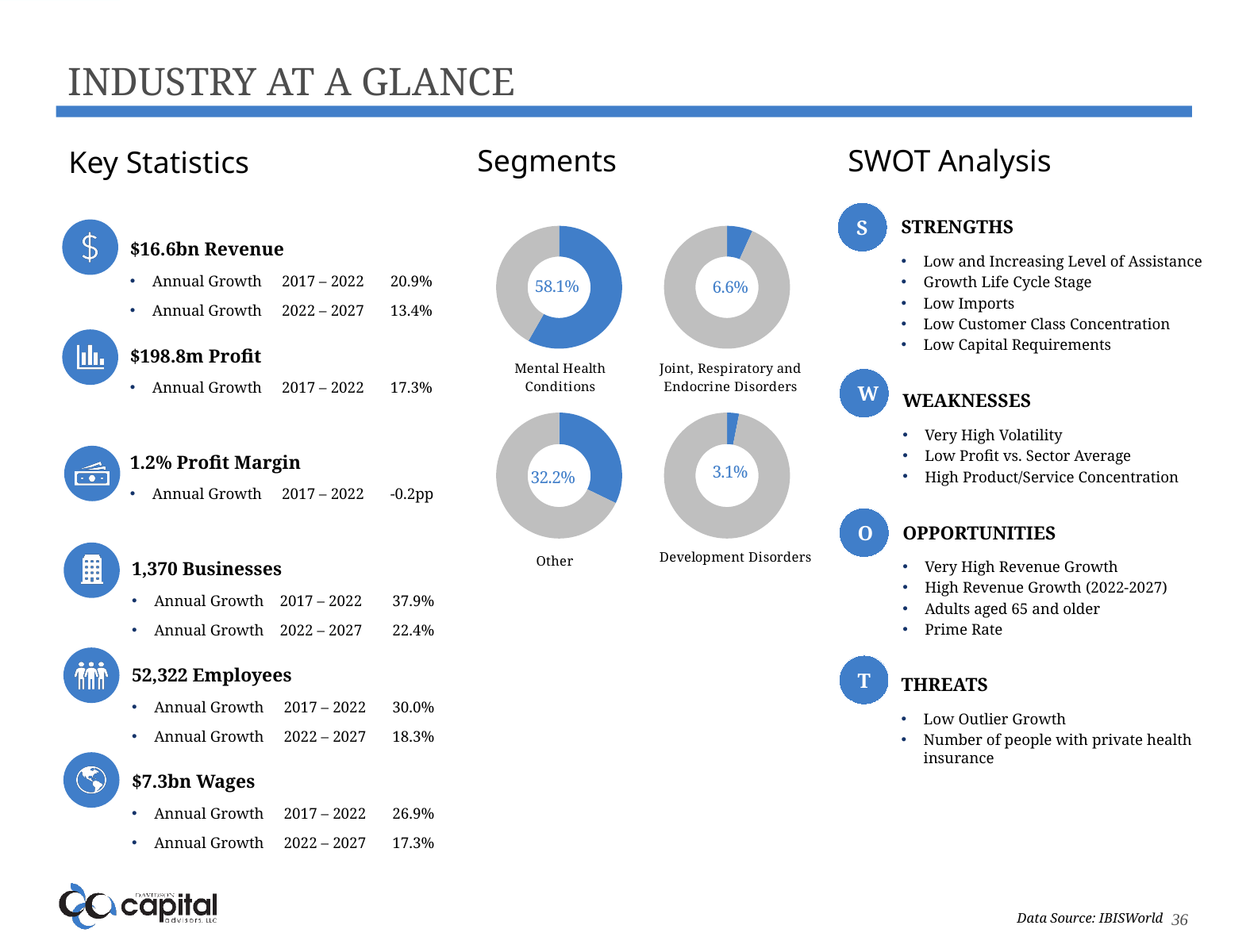
In the Segments section, what is the difference between the Mental Health Conditions share and the Other share? 25.9% In the Segments section, which has a larger share: Other or Joint, Respiratory and Endocrine Disorders? Other In the Segments section, what share is shown in the Other donut chart? 32.2% In the Segments section, what is the difference between the Joint, Respiratory and Endocrine Disorders share and the Development Disorders share? 3.5% In the Segments section, what share is shown in the Mental Health Conditions donut chart? 58.1% Among the four segment donut charts, which segment has the smallest share? Development Disorders How many donut charts are shown in the Segments section? 4 In the Segments section, what share is shown in the Development Disorders donut chart? 3.1% In the Segments section, what share is shown in the Joint, Respiratory and Endocrine Disorders donut chart? 6.6% Among the four segment donut charts, which segment has the largest share? Mental Health Conditions In the Segments donut charts, what colour is used for the highlighted segment share? Blue What type of chart is used to show each segment in the Segments section? Donut chart